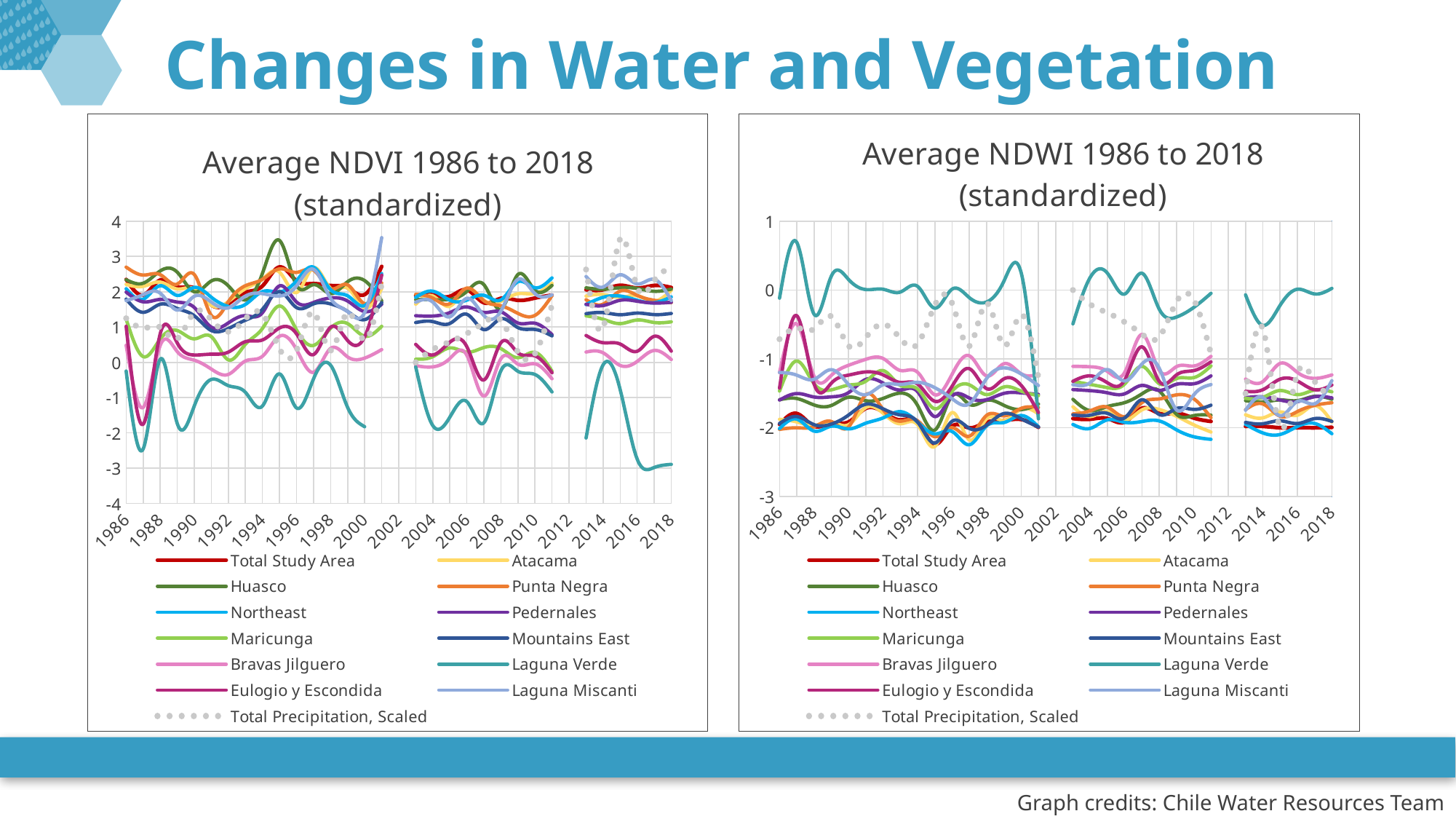
Which series is drawn as a dotted grey line in both charts? Total Precipitation, Scaled What kind of chart is the 'Average NDVI 1986 to 2018 (standardized)' chart? Line chart What kind of chart is the 'Average NDWI 1986 to 2018 (standardized)' chart? Line chart In the 'Average NDWI 1986 to 2018 (standardized)' chart, which series has the highest values over most of 1986 to 2000? Laguna Verde In the 'Average NDVI 1986 to 2018 (standardized)' chart, does the Laguna Verde line rise or fall from 2015 to 2018? Fall In the 'Average NDWI 1986 to 2018 (standardized)' chart, is the peak value for Laguna Verde around 1987 greater or less than 0? greater How many series does the legend of the 'Average NDWI 1986 to 2018 (standardized)' chart list? 13 How many year labels are shown on the x axis of the 'Average NDVI 1986 to 2018 (standardized)' chart? 17 In the 'Average NDVI 1986 to 2018 (standardized)' chart, which series has the lowest value in 2018? Laguna Verde In the 'Average NDWI 1986 to 2018 (standardized)' chart, which is larger in 1990: Laguna Verde or Total Study Area? Laguna Verde In the 'Average NDVI 1986 to 2018 (standardized)' chart, is the value for Laguna Verde in 2018 greater or less than -2? less How many series does the legend of the 'Average NDVI 1986 to 2018 (standardized)' chart list? 13